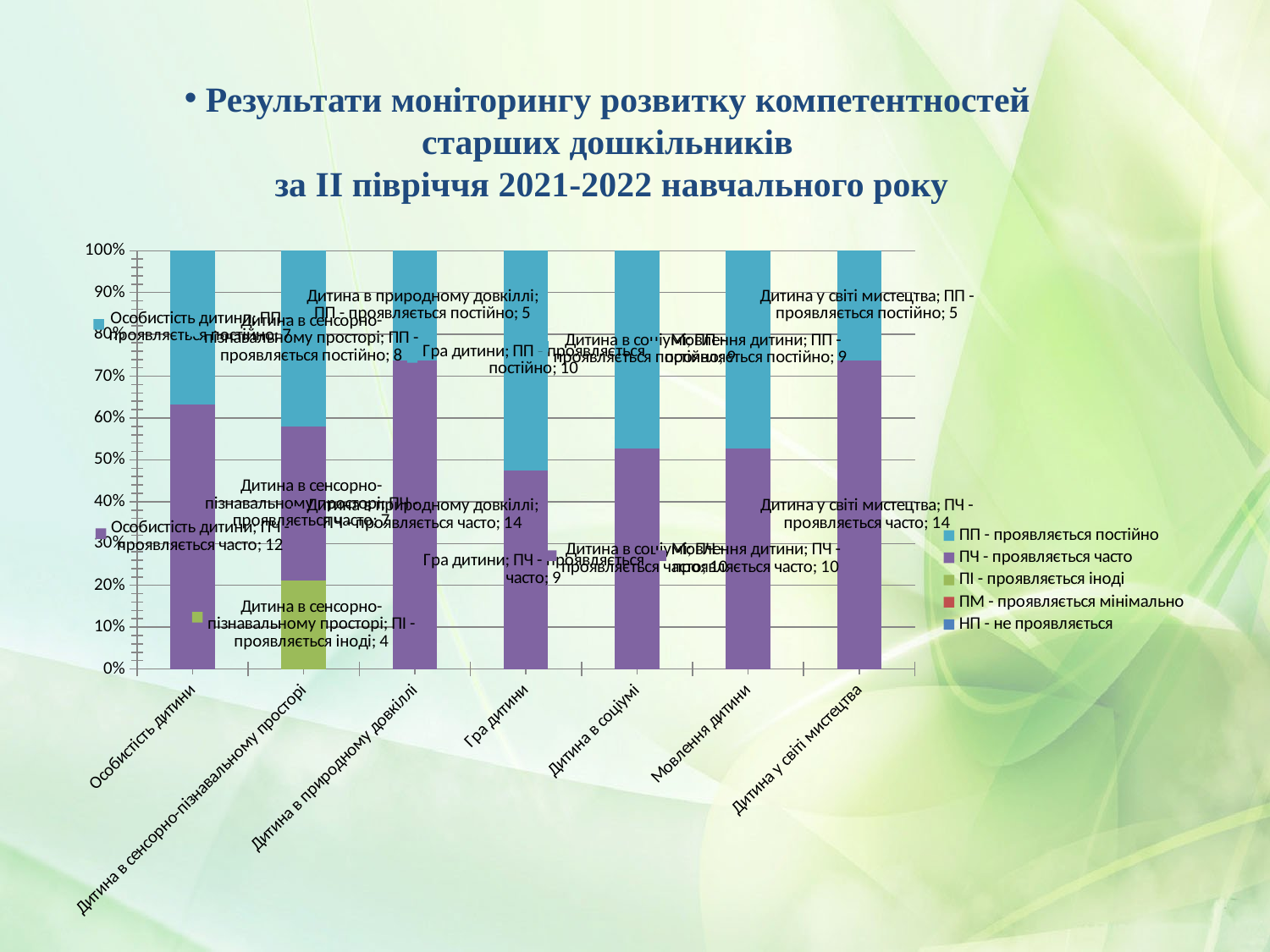
How many series does the legend list? 5 For 'Дитина в природному довкіллі', which is larger: 'ПП - проявляється постійно' or 'ПЧ - проявляється часто'? ПЧ - проявляється часто How many categories are shown along the x axis? 7 Which category is the only one with a 'ПІ - проявляється іноді' segment? Дитина в сенсорно-пізнавальному просторі What is the difference between 'ПЧ - проявляється часто' and 'ПП - проявляється постійно' for 'Дитина у світі мистецтва'? 9 What is the total of the stacked bar for 'Дитина в сенсорно-пізнавальному просторі'? 19 What is the value of 'ПЧ - проявляється часто' for 'Особистість дитини'? 12 What is the value of 'ПП - проявляється постійно' for 'Дитина у світі мистецтва'? 5 What is the value of 'ПЧ - проявляється часто' for 'Дитина в природному довкіллі'? 14 What kind of chart is shown on the slide? Stacked bar chart What is the value of 'ПІ - проявляється іноді' for 'Дитина в сенсорно-пізнавальному просторі'? 4 What is the value of 'ПП - проявляється постійно' for 'Гра дитини'? 10